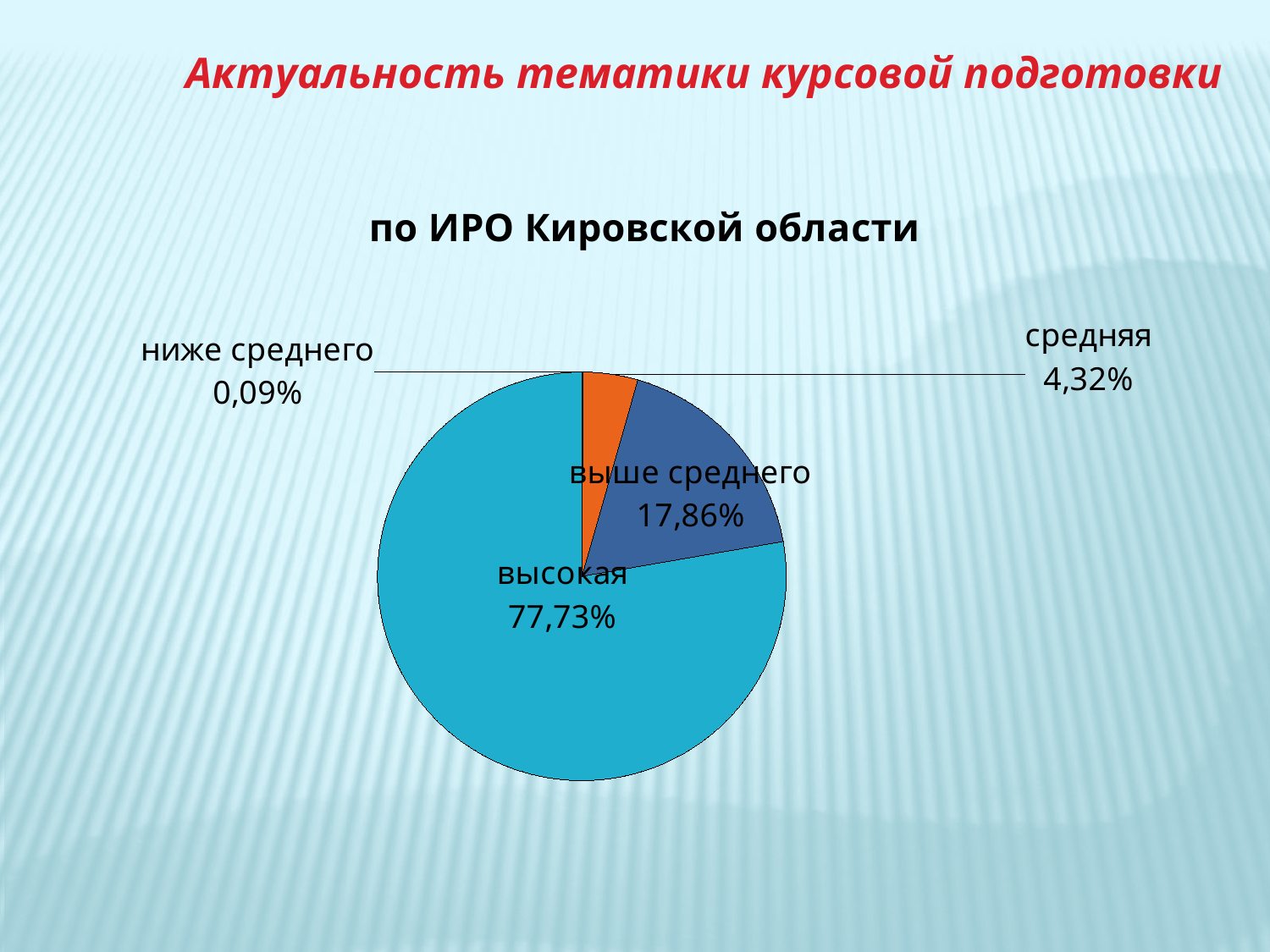
Which is larger, the slice for "выше среднего" or the slice for "средняя"? выше среднего What share of the pie does the "высокая" slice represent? 77,73% Which category has the largest slice of the pie? высокая What is the value shown for "выше среднего"? 17,86% What kind of chart is shown on the slide? Pie chart What colour is the "высокая" slice? Light blue Which category has the smallest slice of the pie? ниже среднего What is the value shown for "ниже среднего"? 0,09% What is the title of the chart? по ИРО Кировской области What is the value shown for "средняя"? 4,32% What is the difference between the values for "высокая" and "выше среднего"? 59,87% How many slices does the pie chart have? 4